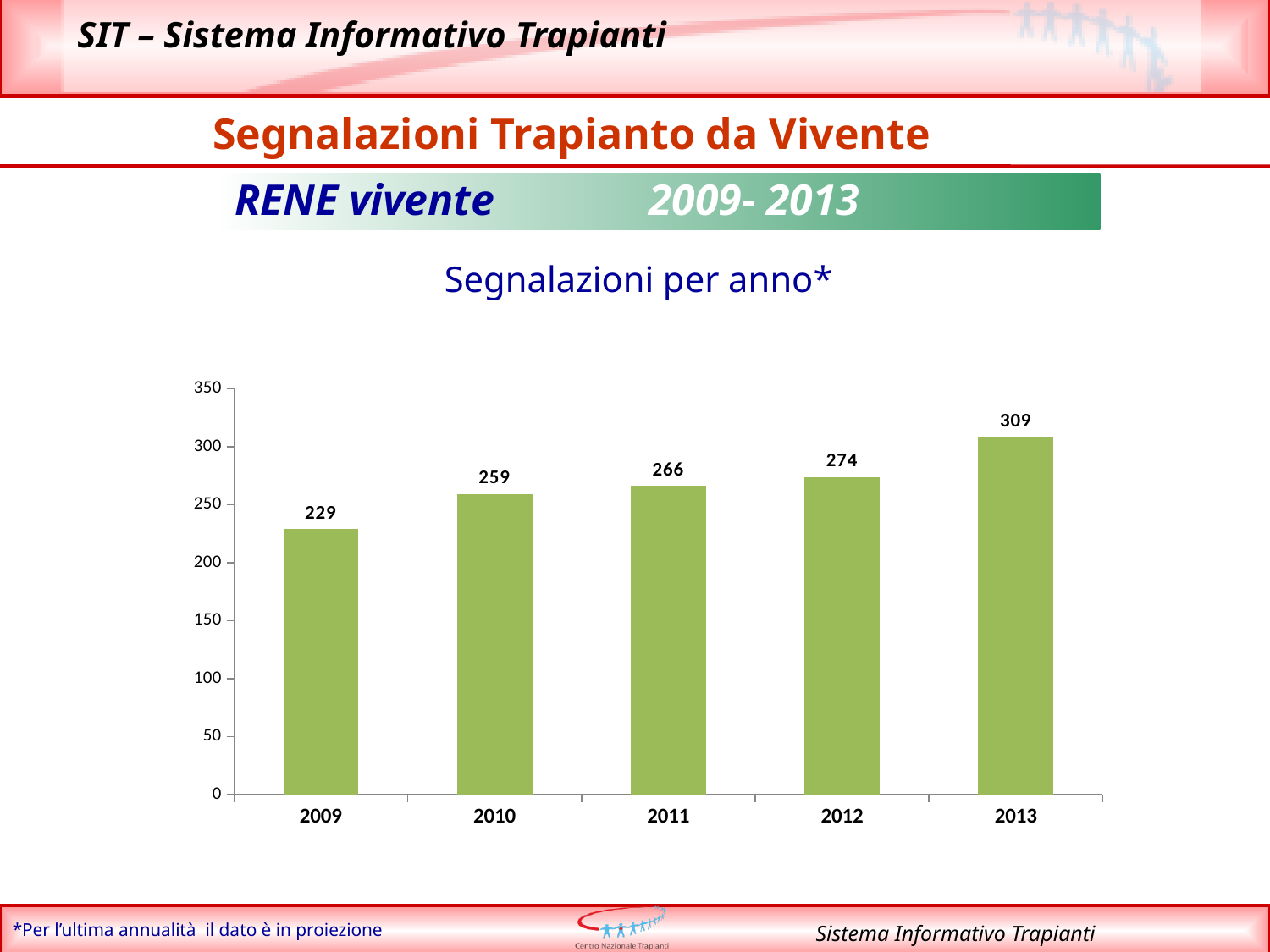
What is the value for 2011? 266 Which is larger, the value for 2010 or the value for 2012? 2012 What is the value for 2013? 309 What is the difference between the values for 2013 and 2012? 35 Do the values rise or fall from 2009 to 2013? rise Is the value for 2013 greater or less than 300? greater What is the difference between the values for 2010 and 2009? 30 Which year has the highest value? 2013 Which year has the lowest value? 2009 What is the value for 2009? 229 How many years are shown on the x axis? 5 What kind of chart is shown? bar chart